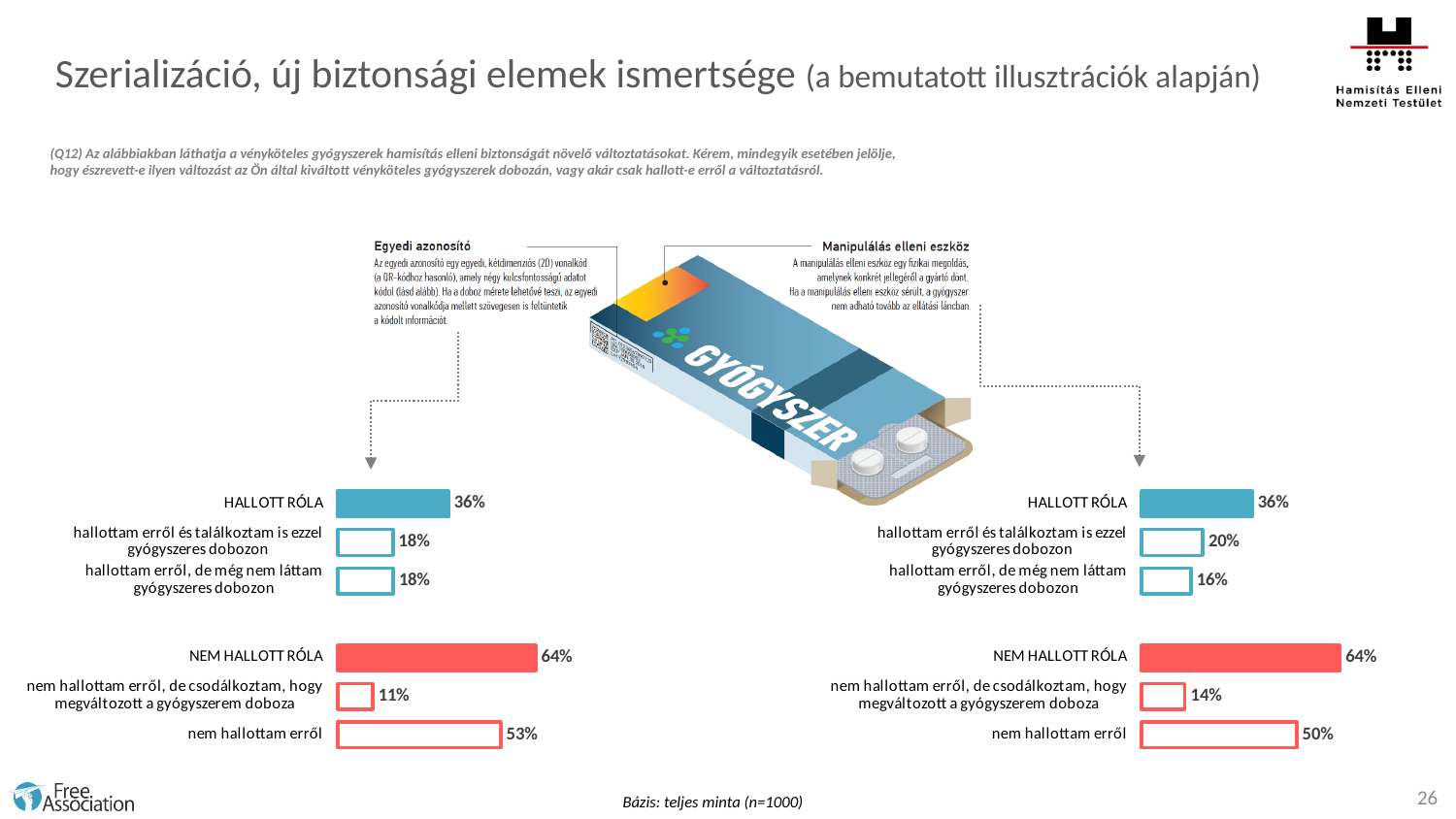
In the left chart (Egyedi azonosító), what percentage is shown for "nem hallottam erről, de csodálkoztam, hogy megváltozott a gyógyszerem doboza"? 11% In the right chart (Manipulálás elleni eszköz), what percentage is shown for "nem hallottam erről"? 50% What type of chart is used on this slide? Bar chart In the right chart (Manipulálás elleni eszköz), what percentage is shown for "hallottam erről és találkoztam is ezzel gyógyszeres dobozon"? 20% In the right chart (Manipulálás elleni eszköz), what is the difference between "hallottam erről és találkoztam is ezzel gyógyszeres dobozon" and "hallottam erről, de még nem láttam gyógyszeres dobozon"? 4% In the left chart (Egyedi azonosító), what percentage is shown for "HALLOTT RÓLA"? 36% Which is larger: "nem hallottam erről" in the left chart (Egyedi azonosító) or "nem hallottam erről" in the right chart (Manipulálás elleni eszköz)? Left chart (Egyedi azonosító), 53% In the left chart (Egyedi azonosító), what is the difference between "NEM HALLOTT RÓLA" and "HALLOTT RÓLA"? 28% In the right chart (Manipulálás elleni eszköz), which category has the lowest value? nem hallottam erről, de csodálkoztam, hogy megváltozott a gyógyszerem doboza How many categories are shown in the left chart (Egyedi azonosító)? 6 In the left chart (Egyedi azonosító), which category has the highest value? NEM HALLOTT RÓLA What is the sample base stated at the bottom of the slide? Bázis: teljes minta (n=1000)